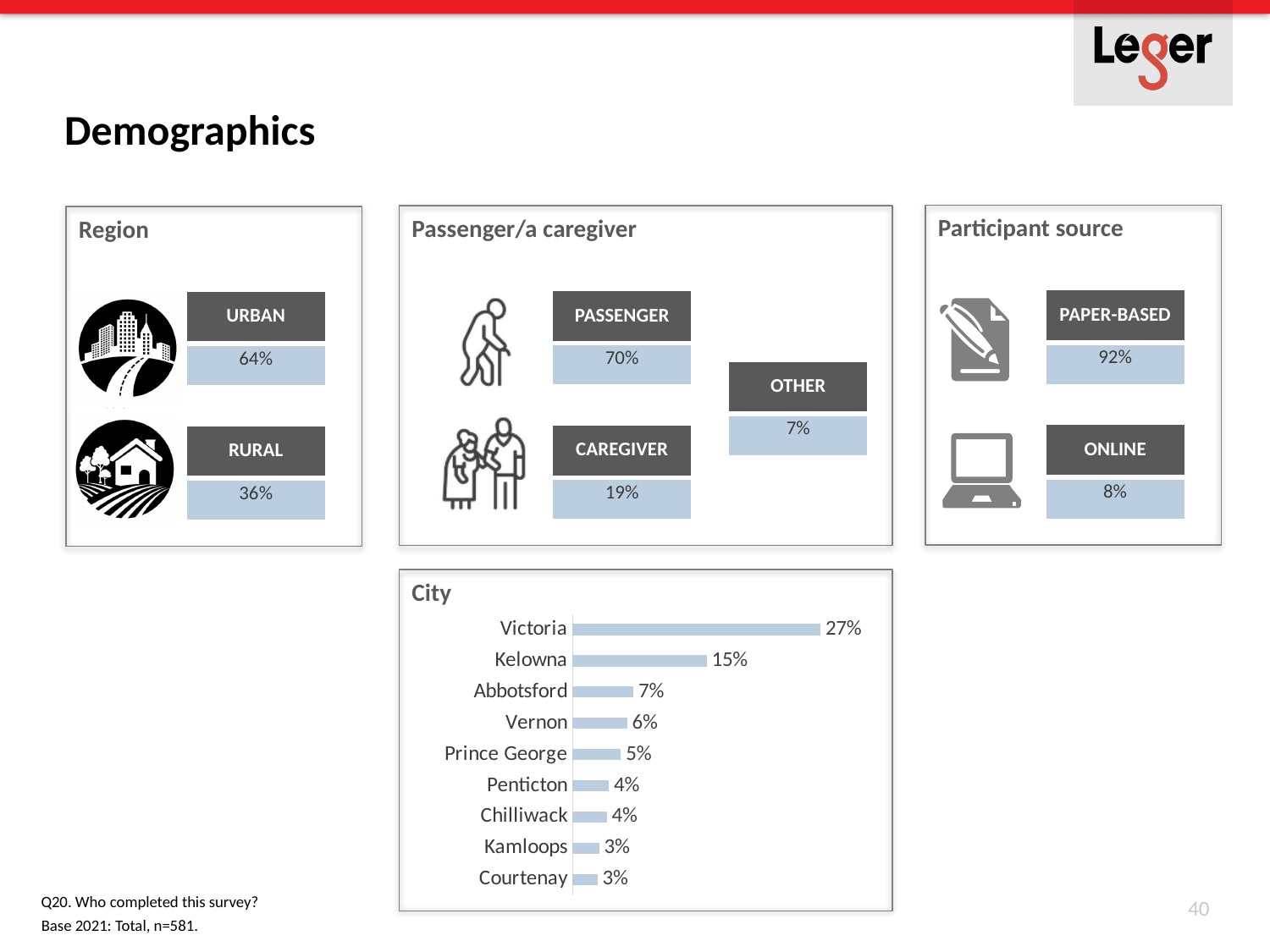
In the City chart, which is larger, Abbotsford or Vernon? Abbotsford In the City chart, what is the difference between Victoria and Kelowna? 12% In the City chart, what is the difference between Abbotsford and Kamloops? 4% What kind of chart is the City chart? bar chart In the City chart, what is the value for Victoria? 27% In the City chart, which city has the highest value? Victoria In the City chart, which two cities both have a value of 4%? Penticton and Chilliwack What is the title of the bar chart at the bottom of the slide? City In the City chart, what is the value for Kelowna? 15% How many cities are listed in the City chart? 9 In the City chart, what is the value for Prince George? 5% In the City chart, do the values rise or fall going down the list from Victoria to Courtenay? fall